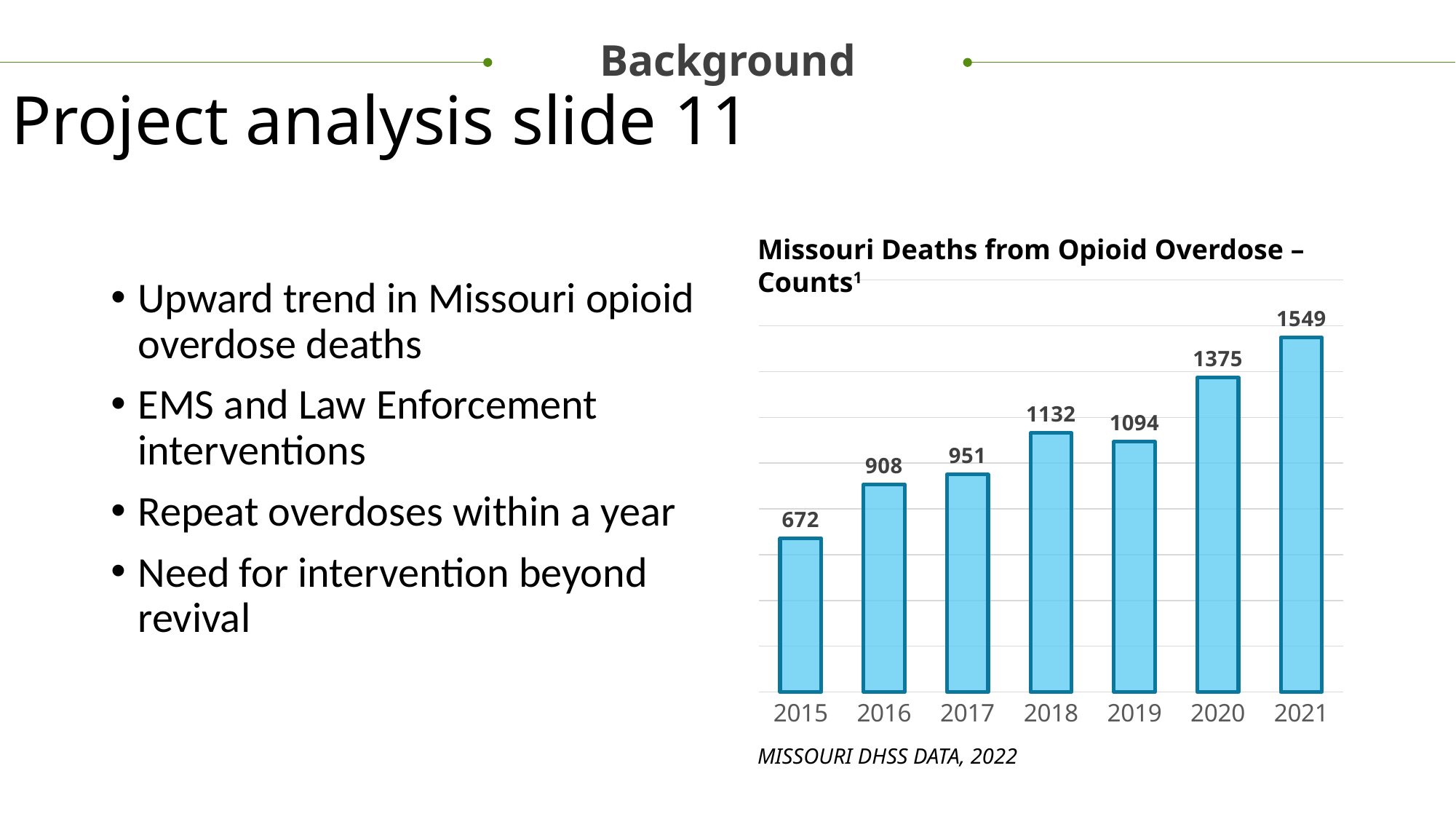
Which year has the highest value? 2021 Which is larger, the value for 2018 or the value for 2019? 2018 What is the value for 2015? 672 What kind of chart is this? bar chart How many years are shown on the x axis? 7 What is the difference between the values for 2018 and 2019? 38 What is the difference between the values for 2021 and 2020? 174 What is the value for 2021? 1549 Which year has the lowest value? 2015 What is the title of the chart? Missouri Deaths from Opioid Overdose – Counts What is the value for 2019? 1094 Do the values generally rise or fall from 2015 to 2021? rise